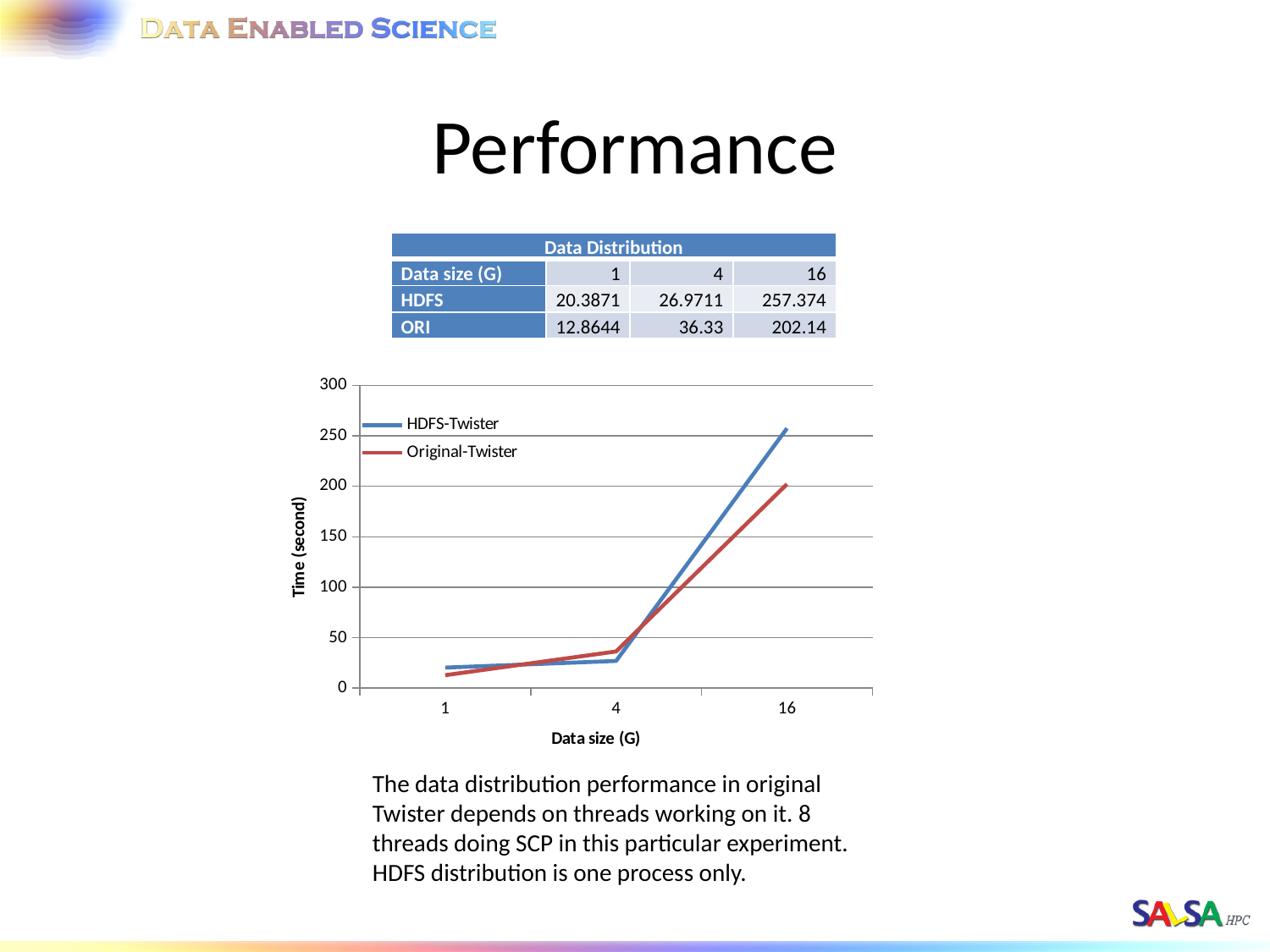
What is the label of the x axis of the chart? Data size (G) Do the HDFS-Twister values rise or fall as data size increases along the x axis? rise According to the Data Distribution table, what is the HDFS time for data size 1 G? 20.3871 According to the Data Distribution table, what is the ORI time for data size 4 G? 36.33 What type of chart is shown on the slide? line chart Is the HDFS-Twister value at data size 16 greater or less than 250? greater According to the Data Distribution table, what is the HDFS time for data size 16 G? 257.374 How many series does the chart legend list? 2 At data size 16, which series has the larger time, HDFS-Twister or Original-Twister? HDFS-Twister What is the label of the y axis of the chart? Time (second) How many data size points are plotted along the x axis of the chart? 3 Is the Original-Twister value at data size 16 greater or less than 250? less